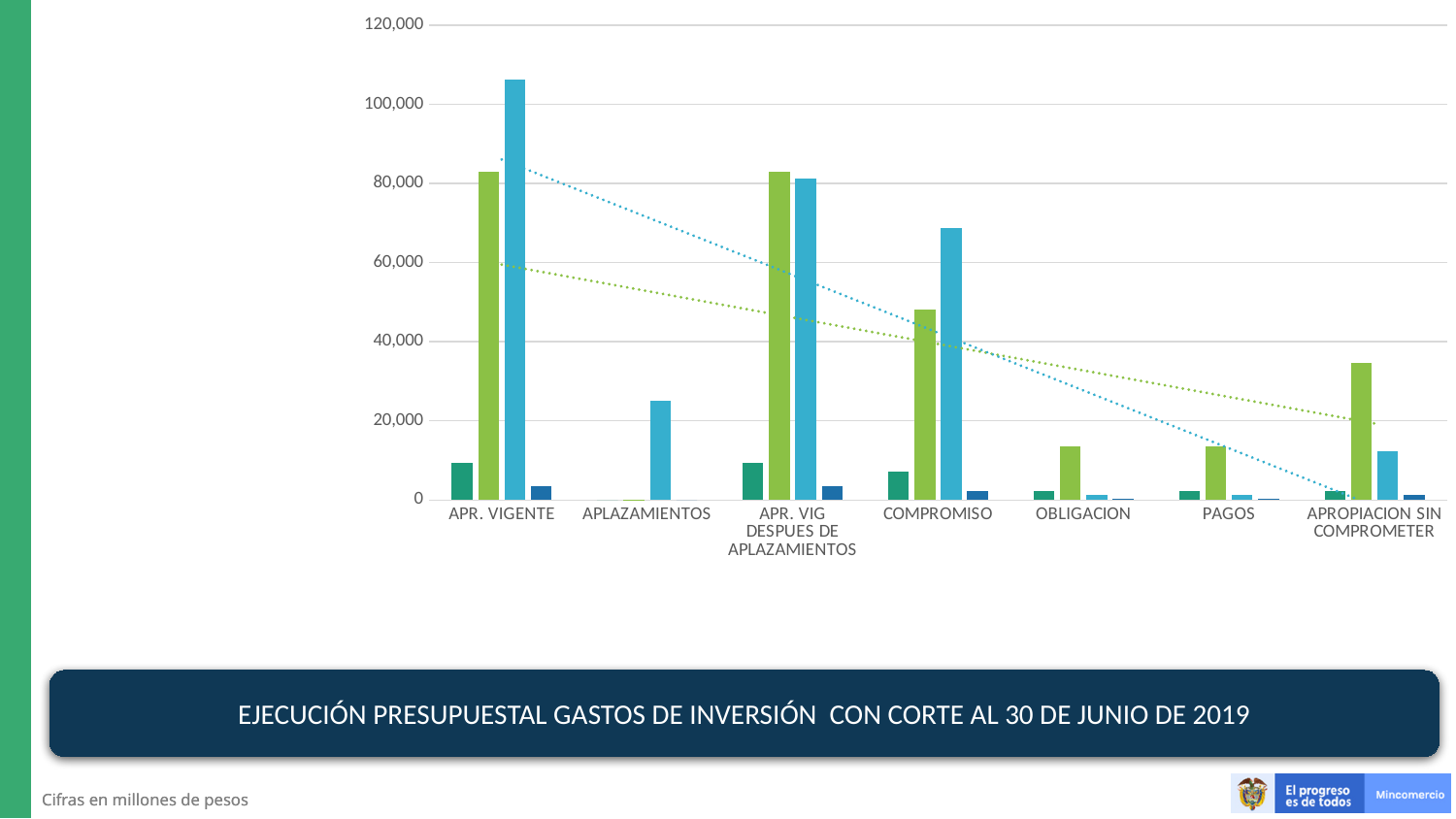
Is the tallest bar for OBLIGACION greater or less than 20,000? less Is the tallest bar for PAGOS greater or less than 20,000? less Which category contains the tallest bar in the chart? APR. VIGENTE Is the tallest bar for APLAZAMIENTOS greater or less than 40,000? less Do the dotted trend lines in the chart rise or fall from left to right? fall How many categories are shown along the x axis of the chart? 7 Which category has a taller tallest bar, COMPROMISO or PAGOS? COMPROMISO What is the title shown in the banner below the chart? EJECUCIÓN PRESUPUESTAL GASTOS DE INVERSIÓN CON CORTE AL 30 DE JUNIO DE 2019 What kind of chart is shown on the slide? bar chart